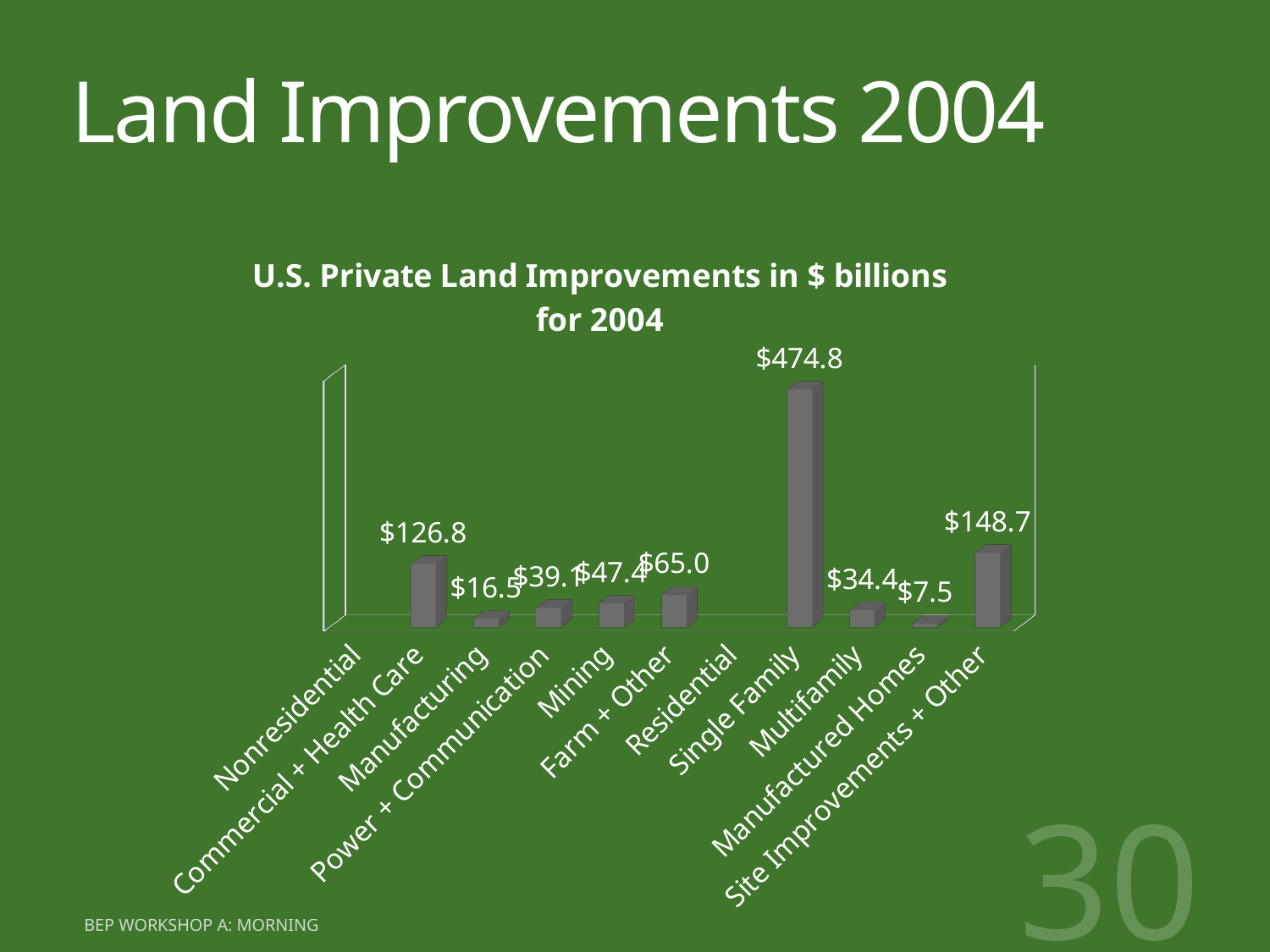
What kind of chart is shown on the slide? Bar chart Which category has the lowest value? Manufactured Homes What is the value for Site Improvements + Other? $148.7 What is the title of the chart? U.S. Private Land Improvements in $ billions for 2004 Which is larger, the value for Mining or the value for Manufacturing? Mining What is the difference between the values for Single Family and Site Improvements + Other? $326.1 What is the value for Commercial + Health Care? $126.8 Which category has the highest value? Single Family What is the value for Multifamily? $34.4 What is the value for Farm + Other? $65.0 What is the value for Single Family? $474.8 What is the value for Manufactured Homes? $7.5